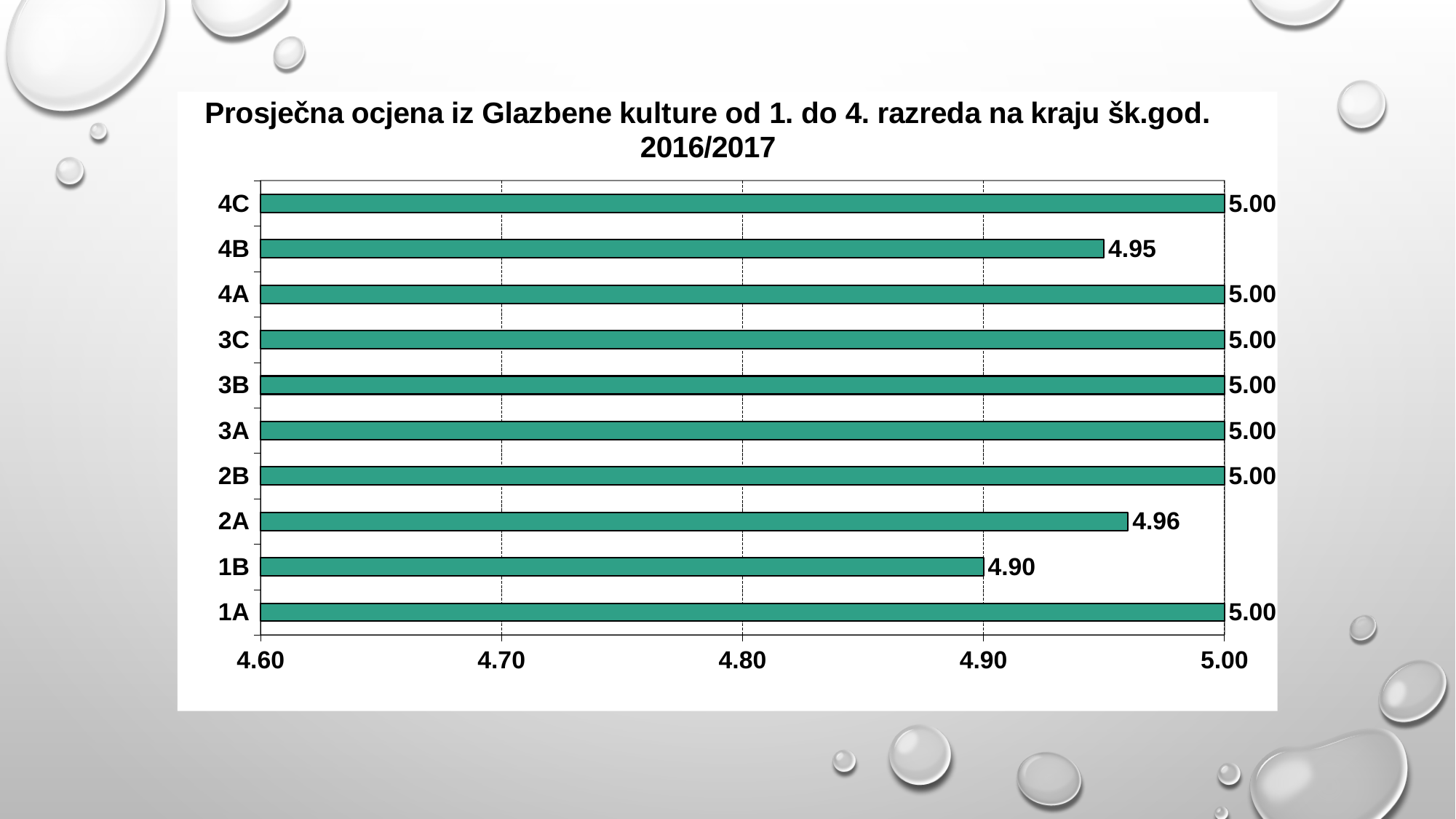
Which is larger, the value for 2A or the value for 1B? 2A Is the value for 4B greater or less than 4.90? greater What is the value for 4B? 4.95 How many classes are shown on the chart? 10 What kind of chart is shown on the slide? bar chart What is the value for 3C? 5.00 How many classes have a value of 5.00? 7 Which class has the lowest average grade? 1B What is the value for 2A? 4.96 What is the difference between the values for 2A and 4B? 0.01 What is the difference between the values for 4C and 1B? 0.10 What is the value for 1B? 4.90